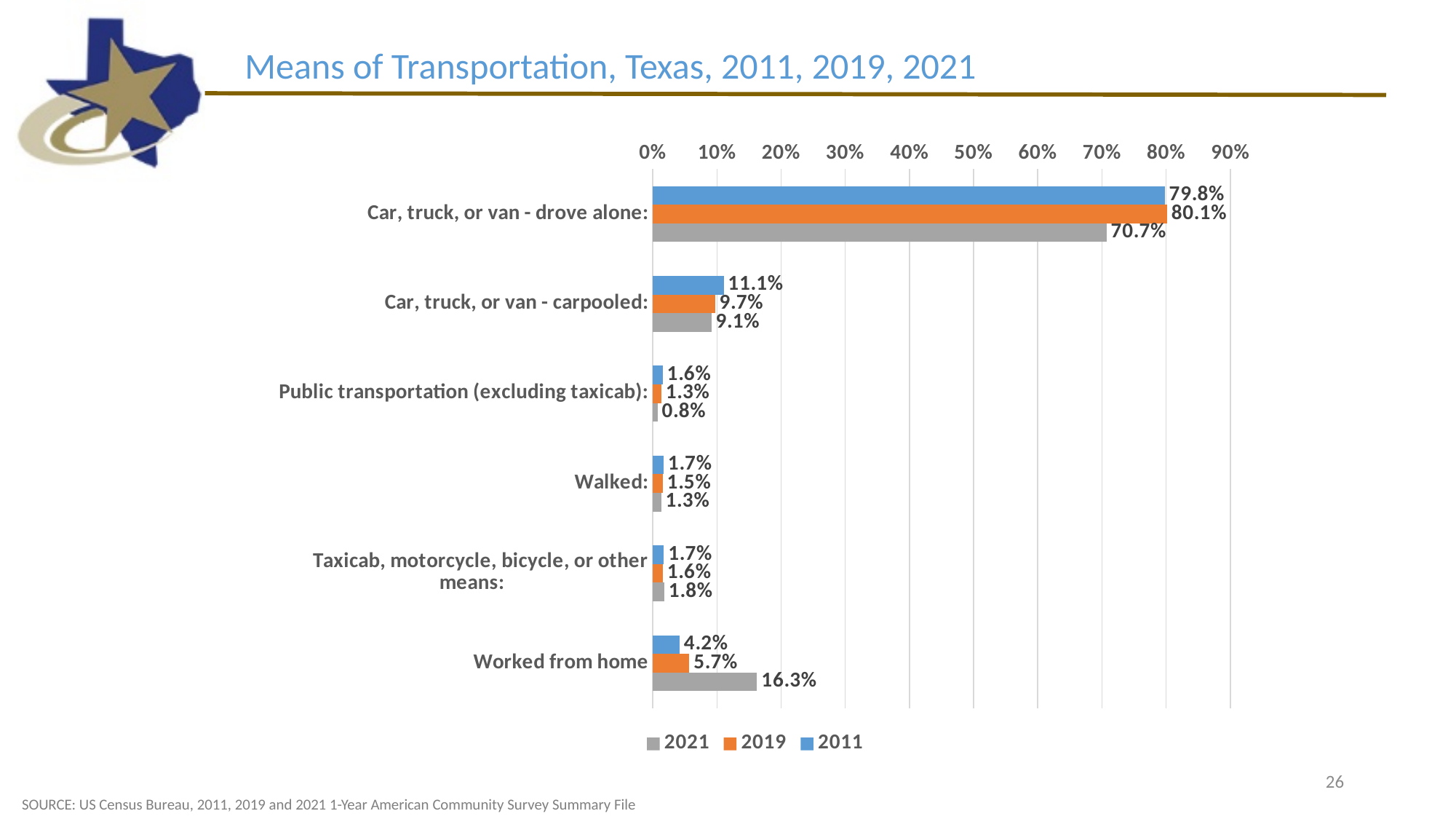
What is the difference between the 2019 and 2021 values for Car, truck, or van - drove alone? 9.4% What is the 2021 value for Public transportation (excluding taxicab)? 0.8% What is the 2019 value for Car, truck, or van - carpooled? 9.7% What is the 2021 value for Worked from home? 16.3% What is the 2011 value for Car, truck, or van - drove alone? 79.8% Which category has the highest 2021 value? Car, truck, or van - drove alone What is the title of the chart? Means of Transportation, Texas, 2011, 2019, 2021 Which category has the lowest 2011 value? Public transportation (excluding taxicab) How many series does the legend list? 3 What kind of chart is shown on the slide? Bar chart How many transportation categories are shown on the chart? 6 Which is larger for Worked from home: the 2011 value or the 2021 value? 2021